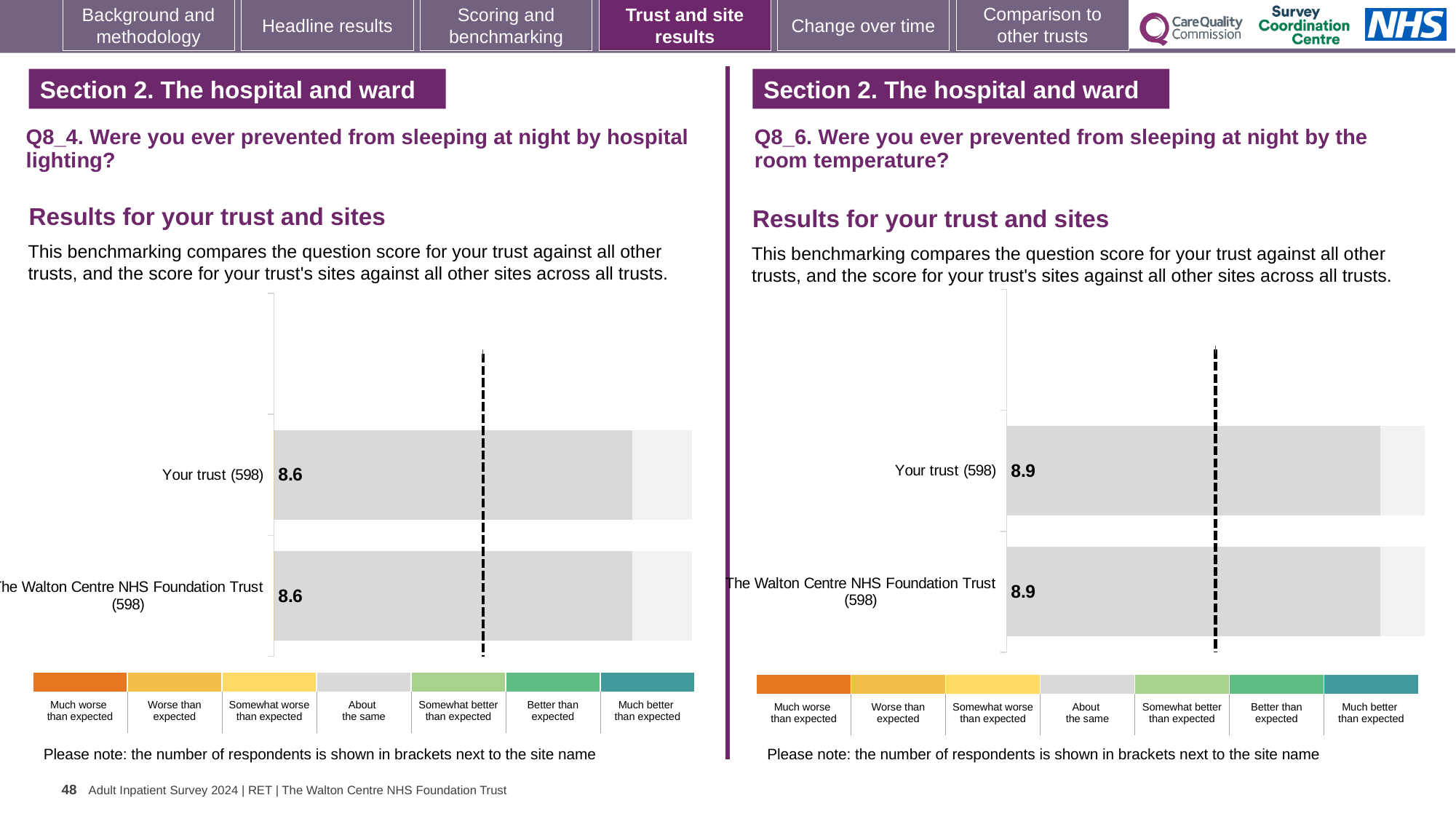
What kind of chart is used in the Q8_4 chart (hospital lighting)? Bar chart How many categories does the colour legend below the Q8_4 chart (hospital lighting) list? 7 How many bars are plotted in the Q8_6 chart (room temperature)? 2 How many respondents are shown in brackets for Your trust in the Q8_6 chart (room temperature)? 598 In the Q8_4 chart (hospital lighting), what is the score for Your trust? 8.6 How many bars are plotted in the Q8_4 chart (hospital lighting)? 2 In the Q8_4 chart (hospital lighting), what is the difference between the Your trust score and The Walton Centre NHS Foundation Trust score? 0 In the Q8_6 chart (room temperature), is the Your trust score larger than, smaller than, or equal to The Walton Centre NHS Foundation Trust score? equal In the Q8_6 chart (room temperature), what is the score for The Walton Centre NHS Foundation Trust? 8.9 In the Q8_4 chart (hospital lighting), what is the score for The Walton Centre NHS Foundation Trust? 8.6 In the legend below the Q8_6 chart (room temperature), which category is shown in orange at the far left? Much worse than expected In the Q8_6 chart (room temperature), what is the score for Your trust? 8.9